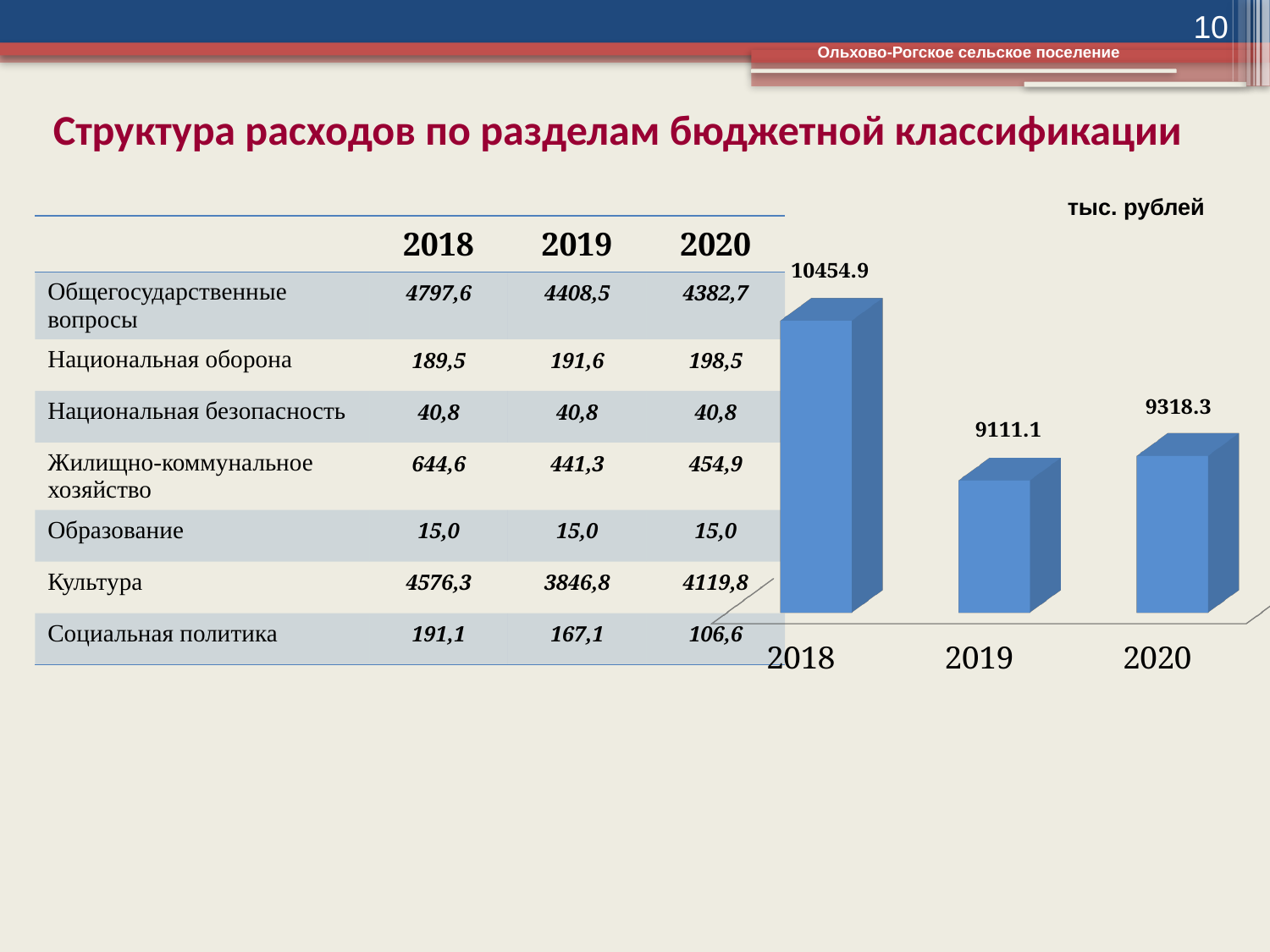
What is the value shown for 2018 on the chart? 10454.9 What is the difference between the values for 2020 and 2019 on the chart? 207.2 Which year has the lowest value on the chart? 2019 How many bars are plotted on the chart? 3 What is the difference between the values for 2018 and 2019 on the chart? 1343.8 Which year has the highest value on the chart? 2018 What is the value shown for 2019 on the chart? 9111.1 What kind of chart is shown on the slide? Bar chart Does the value on the chart rise or fall from 2018 to 2019? Fall In what units are the chart values given, according to the label above the chart? тыс. рублей What is the value shown for 2020 on the chart? 9318.3 Which is larger on the chart, the value for 2019 or the value for 2020? 2020